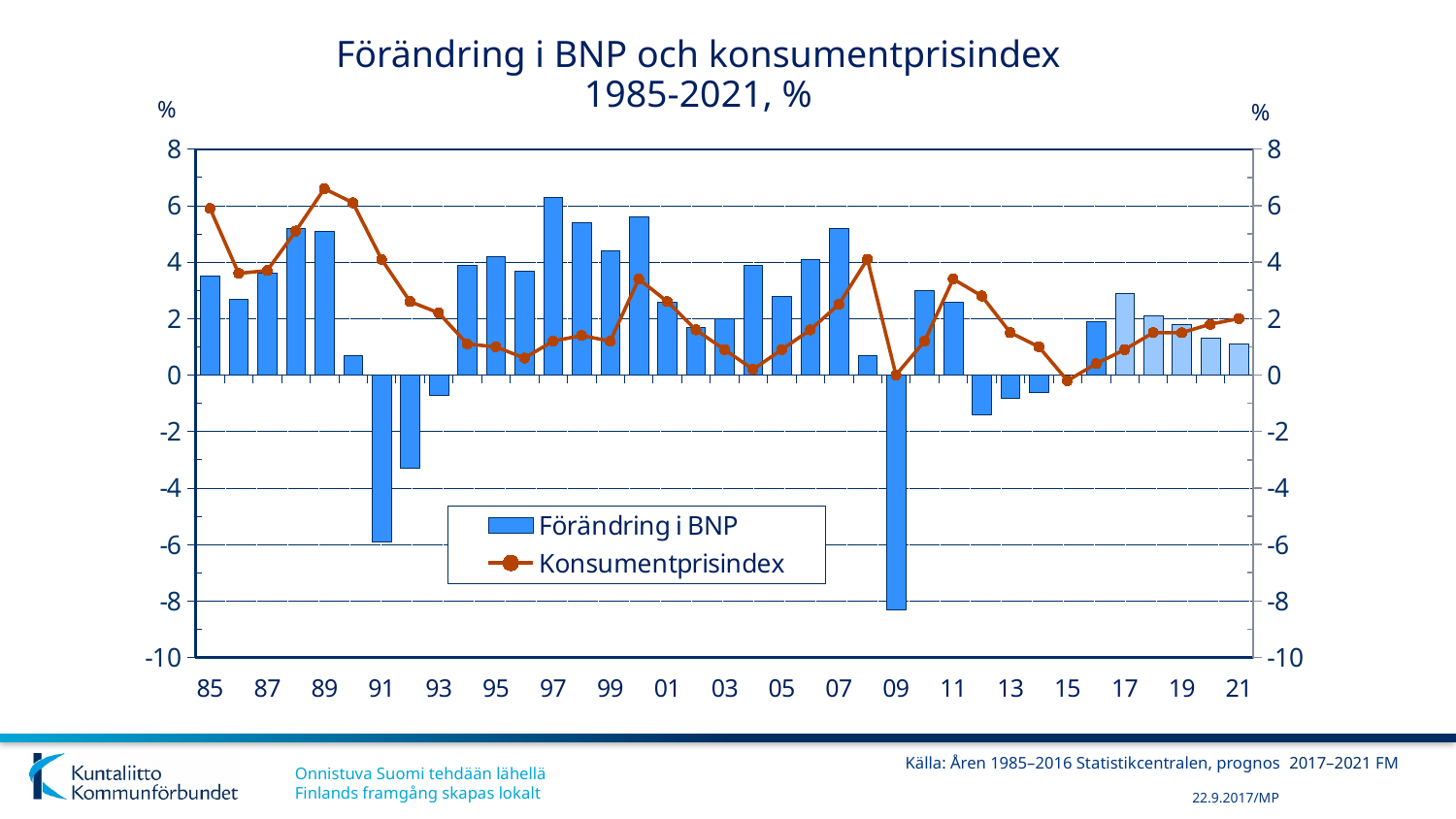
Which year has the higher Konsumentprisindex value, 89 or 09? 89 What kind of chart is shown on the slide? A combined bar and line chart In which year is the Förändring i BNP bar highest? 97 Which year has the lower Förändring i BNP value, 91 or 09? 09 Is the Konsumentprisindex value for 85 greater or less than 4? greater In which year does the Konsumentprisindex line reach its highest point? 89 How many series does the legend list? 2 What are the two series named in the legend? Förändring i BNP and Konsumentprisindex Does the Konsumentprisindex line rise or fall between 89 and 94? fall In which year is the Förändring i BNP bar lowest? 09 What is the title of the chart? Förändring i BNP och konsumentprisindex 1985-2021, % Is the Förändring i BNP value for 09 greater or less than -6? less